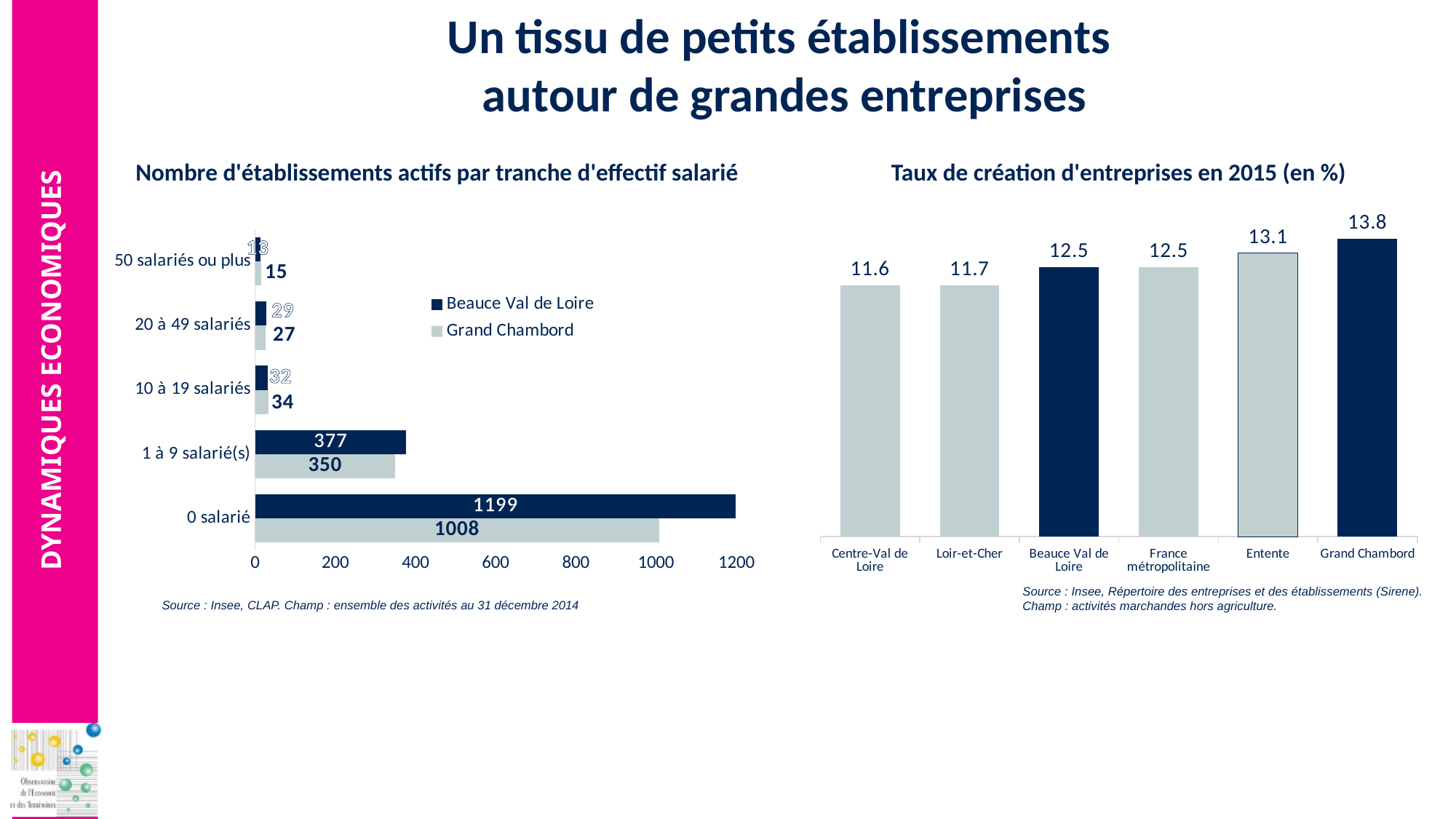
In the chart 'Nombre d'établissements actifs par tranche d'effectif salarié', what is the difference between Beauce Val de Loire and Grand Chambord in the '0 salarié' category? 191 In the chart 'Taux de création d'entreprises en 2015 (en %)', what is the value for Grand Chambord? 13.8 In the chart 'Taux de création d'entreprises en 2015 (en %)', which category has the lowest value? Centre-Val de Loire In the chart 'Nombre d'établissements actifs par tranche d'effectif salarié', what is the value for Beauce Val de Loire in the '0 salarié' category? 1199 In the chart 'Nombre d'établissements actifs par tranche d'effectif salarié', what is the value for Grand Chambord in the '1 à 9 salarié(s)' category? 350 In the chart 'Nombre d'établissements actifs par tranche d'effectif salarié', how many employee-size categories are shown? 5 In the chart 'Nombre d'établissements actifs par tranche d'effectif salarié', which series has the larger value in the '10 à 19 salariés' category? Grand Chambord What kind of chart is 'Nombre d'établissements actifs par tranche d'effectif salarié'? Bar chart In the chart 'Nombre d'établissements actifs par tranche d'effectif salarié', how many series does the legend list? 2 In the chart 'Taux de création d'entreprises en 2015 (en %)', which category has the highest value? Grand Chambord In the chart 'Taux de création d'entreprises en 2015 (en %)', what is the difference between Entente and Loir-et-Cher? 1.4 In the chart 'Taux de création d'entreprises en 2015 (en %)', how many categories are shown? 6